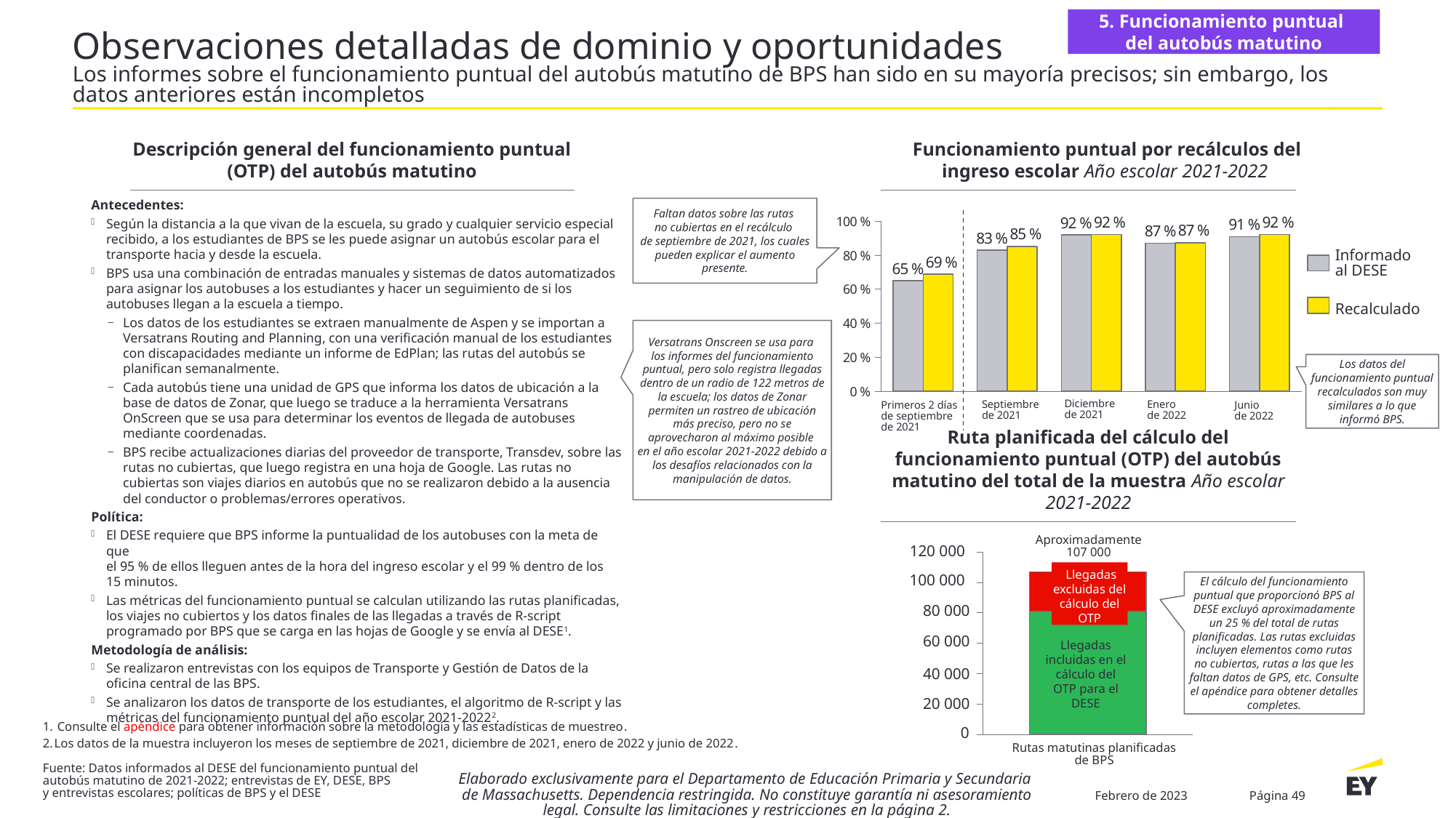
In the chart 'Funcionamiento puntual por recálculos del ingreso escolar', what is the difference between the 'Recalculado' and 'Informado al DESE' values for Primeros 2 días de septiembre de 2021? 4 % In the chart 'Funcionamiento puntual por recálculos del ingreso escolar', how many periods are shown on the x axis? 5 In the chart 'Ruta planificada del cálculo del funcionamiento puntual (OTP) del autobús matutino del total de la muestra', which colour represents 'Llegadas excluidas del cálculo del OTP'? Red What kind of chart is 'Funcionamiento puntual por recálculos del ingreso escolar'? Bar chart In the chart 'Funcionamiento puntual por recálculos del ingreso escolar', how many series does the legend list? 2 In the chart 'Funcionamiento puntual por recálculos del ingreso escolar', is the 'Informado al DESE' value higher for Enero de 2022 or for Junio de 2022? Junio de 2022 In the chart 'Funcionamiento puntual por recálculos del ingreso escolar', which period has the lowest 'Informado al DESE' value? Primeros 2 días de septiembre de 2021 In the chart 'Funcionamiento puntual por recálculos del ingreso escolar', what is the 'Recalculado' value for Primeros 2 días de septiembre de 2021? 69 % In the chart 'Funcionamiento puntual por recálculos del ingreso escolar', what is the 'Recalculado' value for Junio de 2022? 92 % In the chart 'Funcionamiento puntual por recálculos del ingreso escolar', which period has the highest 'Informado al DESE' value? Diciembre de 2021 In the chart 'Ruta planificada del cálculo del funcionamiento puntual (OTP) del autobús matutino del total de la muestra', is the 'Llegadas incluidas en el cálculo del OTP para el DESE' segment greater or less than 60 000? greater In the chart 'Funcionamiento puntual por recálculos del ingreso escolar', what is the 'Informado al DESE' value for Septiembre de 2021? 83 %